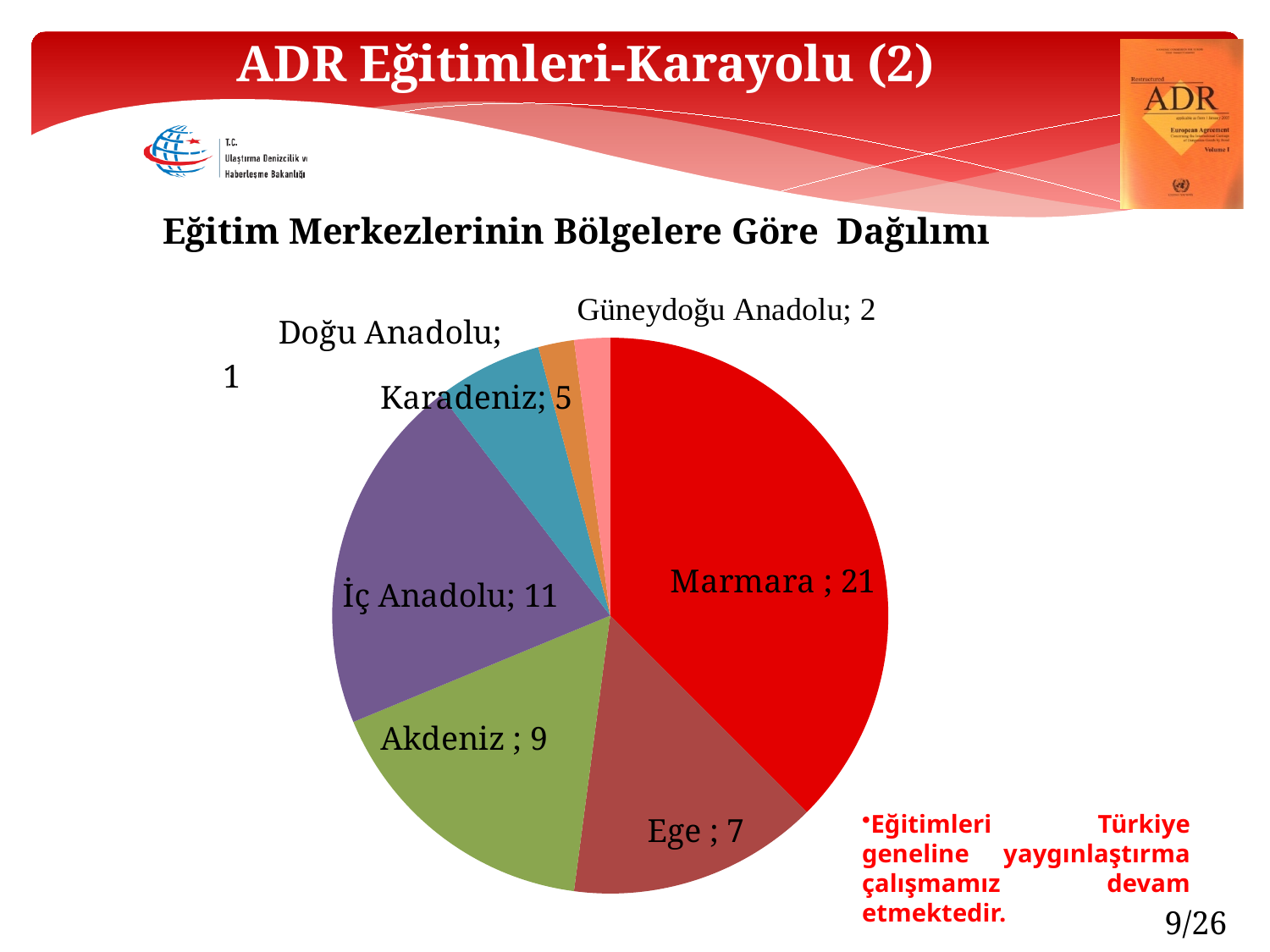
What is the value for Güneydoğu Anadolu? 2 Which region has the smallest slice? Doğu Anadolu What is the title of the chart? Eğitim Merkezlerinin Bölgelere Göre Dağılımı What is the value for İç Anadolu? 11 What is the difference between the values for Marmara and Ege? 14 What share of the total does Marmara represent? 37.5% What is the value for Marmara? 21 What is the value for Karadeniz? 5 How many slices does the pie chart have? 7 Which is larger, the value for Akdeniz or the value for Ege? Akdeniz What kind of chart is shown on the slide? pie chart Which region has the largest slice? Marmara